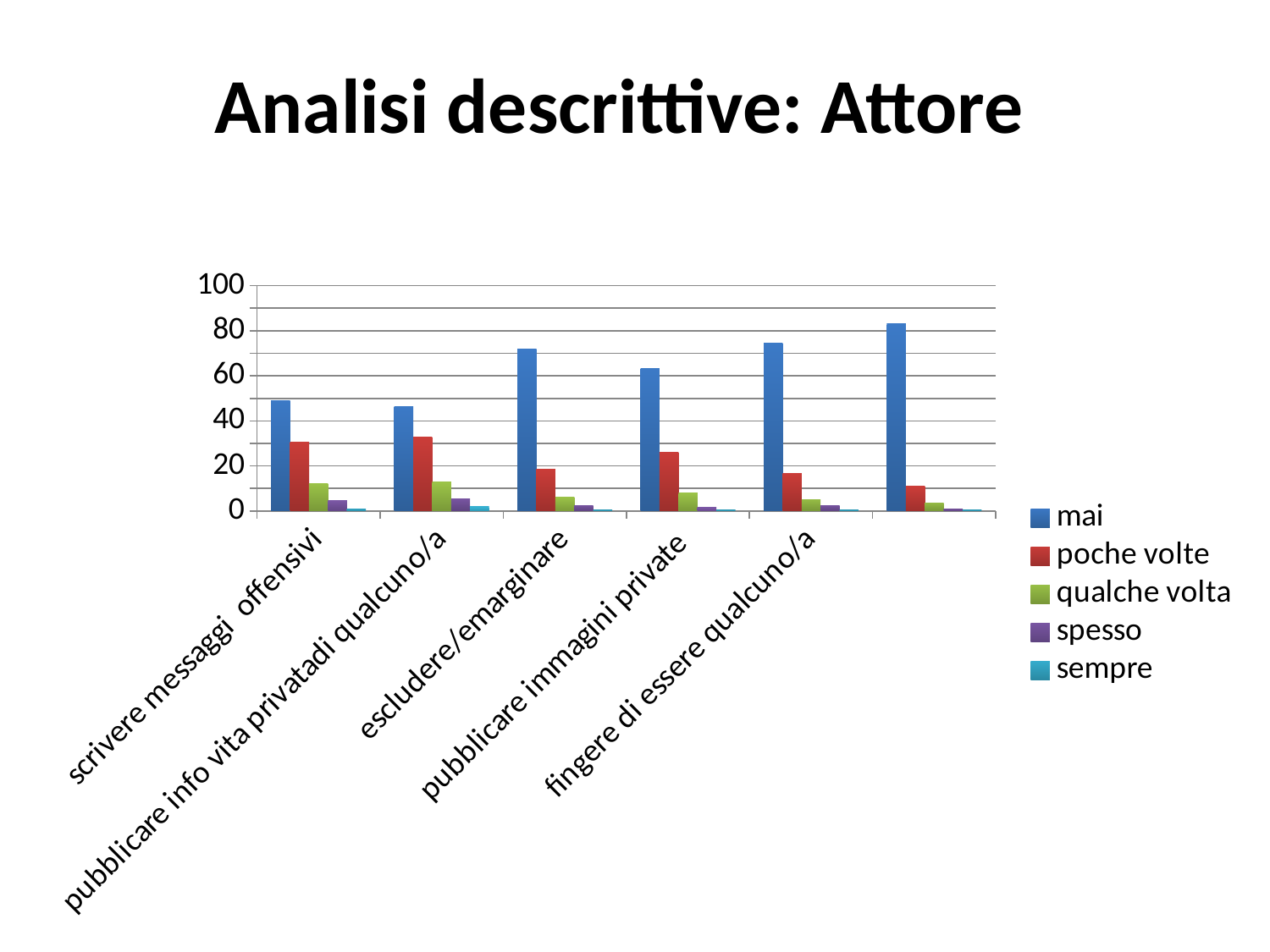
Which colour represents the "mai" series in the legend? blue Is the value of "mai" for "pubblicare immagini private" greater or less than 40? greater What kind of chart is shown on the slide? bar chart Which has the larger "poche volte" value: "scrivere messaggi offensivi" or "escludere/emarginare"? scrivere messaggi offensivi How many series does the legend list? 5 Is the value of "mai" for "scrivere messaggi offensivi" greater or less than 60? less Is the value of "mai" for "escludere/emarginare" greater or less than 60? greater For "scrivere messaggi offensivi", which series has the larger value: "mai" or "poche volte"? mai What is the title of the slide? Analisi descrittive: Attore Which has the larger "mai" value: "escludere/emarginare" or "pubblicare immagini private"? escludere/emarginare